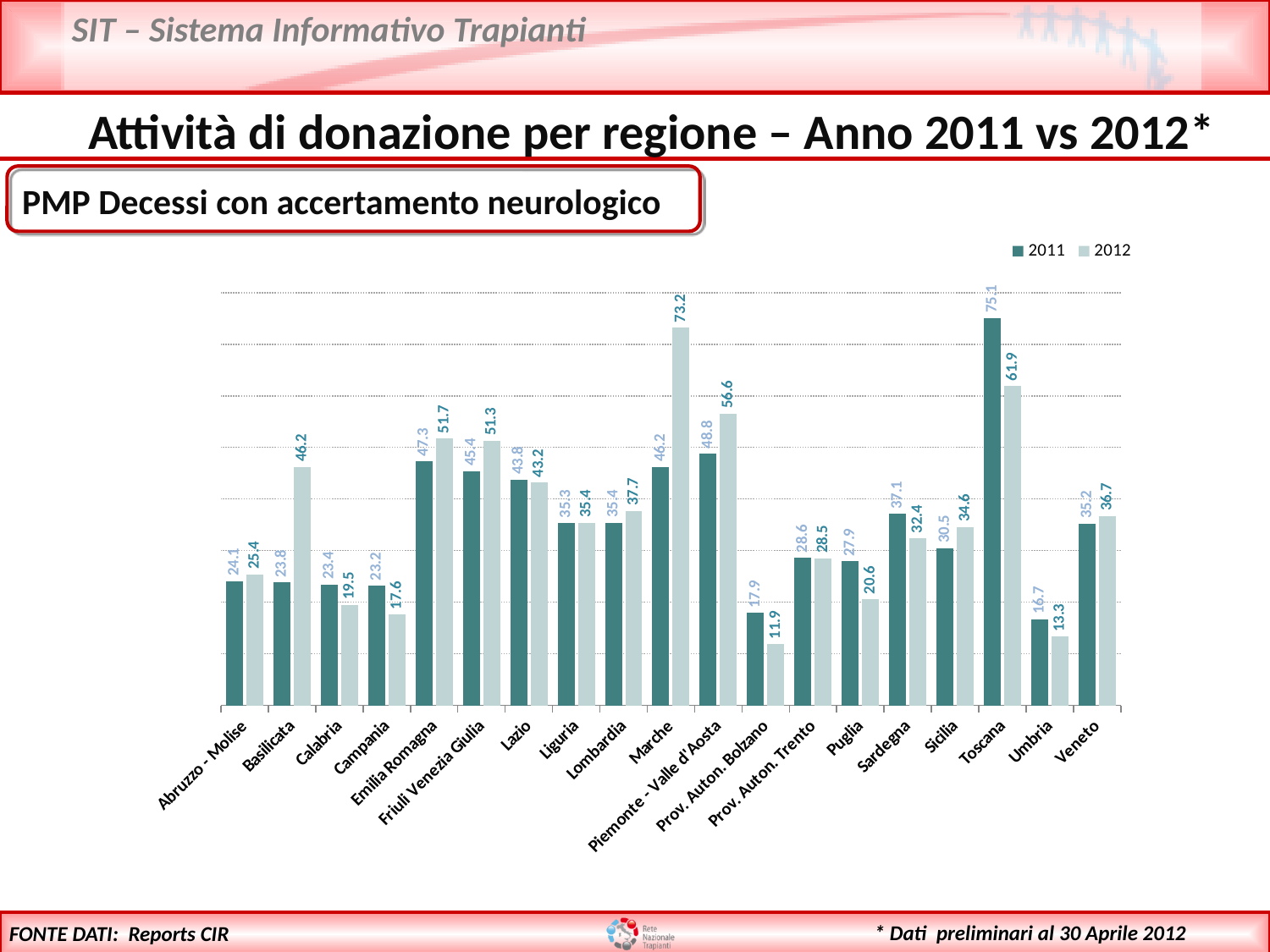
Which is larger for Basilicata, the 2011 value or the 2012 value? 2012 Which region has the lowest 2011 value? Umbria Which region has the highest 2012 value? Marche Which region has the highest 2011 value? Toscana What is the 2012 value for Marche? 73.2 What is the 2012 value for Prov. Auton. Bolzano? 11.9 Which region has the lowest 2012 value? Prov. Auton. Bolzano What is the difference between the 2012 and 2011 values for Marche? 27.0 What is the 2011 value for Toscana? 75.1 How many regions are shown on the x axis? 19 How many series does the legend list? 2 What is the 2011 value for Piemonte - Valle d'Aosta? 48.8